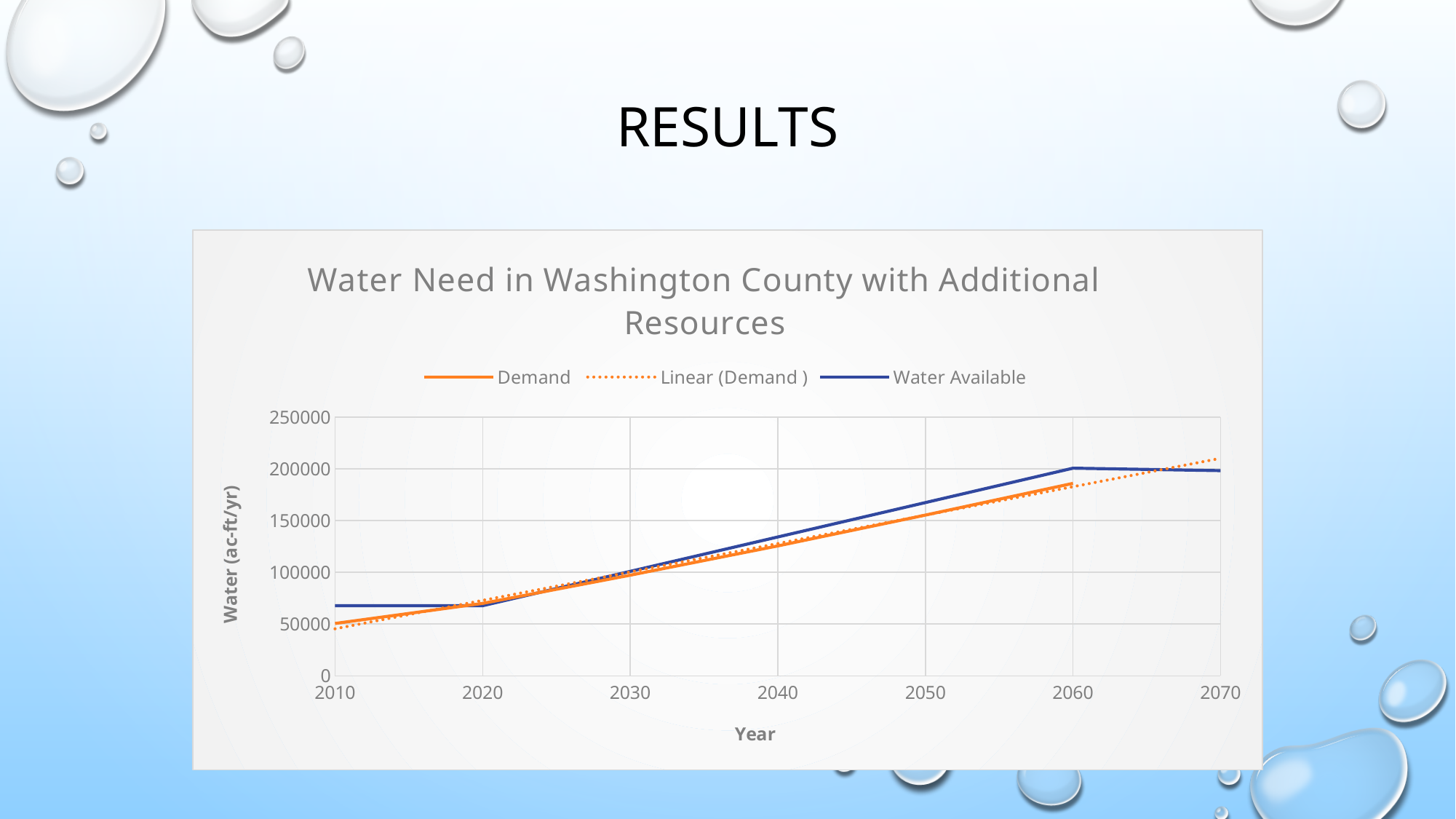
How many year labels are shown on the x axis? 7 In 2010, which is higher: Water Available or Demand? Water Available Is the Water Available value in 2010 greater or less than 100000? less Does the Demand line rise or fall from 2010 to 2060? rise In 2050, which is higher: Water Available or Demand? Water Available What kind of chart is shown on the slide? line chart What is the label of the vertical axis? Water (ac-ft/yr) What is the title of the chart? Water Need in Washington County with Additional Resources Is the Demand value in 2030 greater or less than 150000? less Is the Water Available value in 2070 greater or less than 150000? greater How many series does the legend list? 3